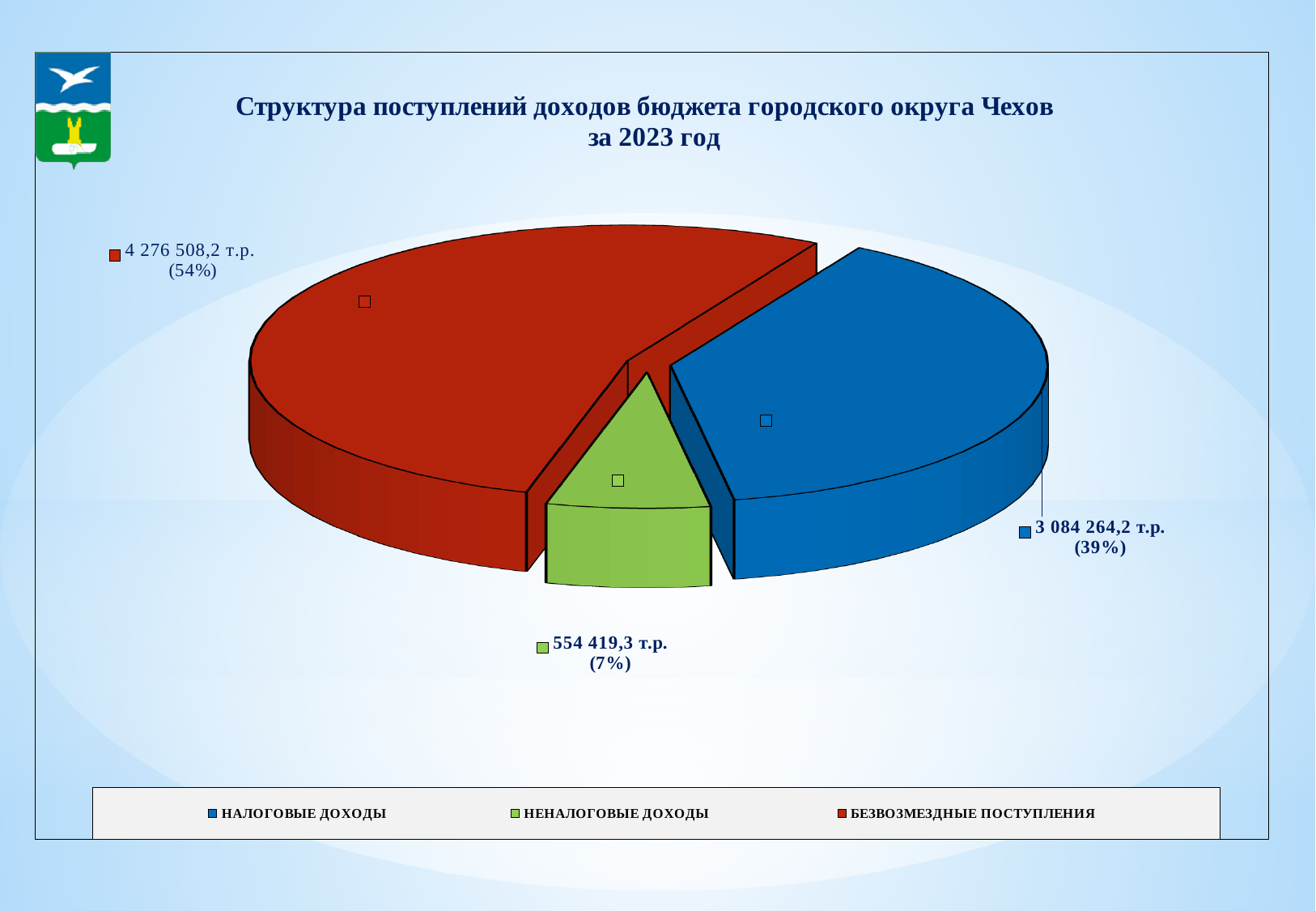
Which category has the largest slice? БЕЗВОЗМЕЗДНЫЕ ПОСТУПЛЕНИЯ What is the value for НАЛОГОВЫЕ ДОХОДЫ? 3 084 264,2 т.р. What is the difference between the values for БЕЗВОЗМЕЗДНЫЕ ПОСТУПЛЕНИЯ and НАЛОГОВЫЕ ДОХОДЫ? 1 192 244,0 т.р. How many categories does the pie chart have? 3 What share of the pie does БЕЗВОЗМЕЗДНЫЕ ПОСТУПЛЕНИЯ represent? 54% Which category has the smallest slice? НЕНАЛОГОВЫЕ ДОХОДЫ What colour is the slice for НЕНАЛОГОВЫЕ ДОХОДЫ? Green What is the value for БЕЗВОЗМЕЗДНЫЕ ПОСТУПЛЕНИЯ? 4 276 508,2 т.р. What type of chart is shown on the slide? Pie chart What share of the pie does НАЛОГОВЫЕ ДОХОДЫ represent? 39% What is the value for НЕНАЛОГОВЫЕ ДОХОДЫ? 554 419,3 т.р. Which is larger, НАЛОГОВЫЕ ДОХОДЫ or НЕНАЛОГОВЫЕ ДОХОДЫ? НАЛОГОВЫЕ ДОХОДЫ